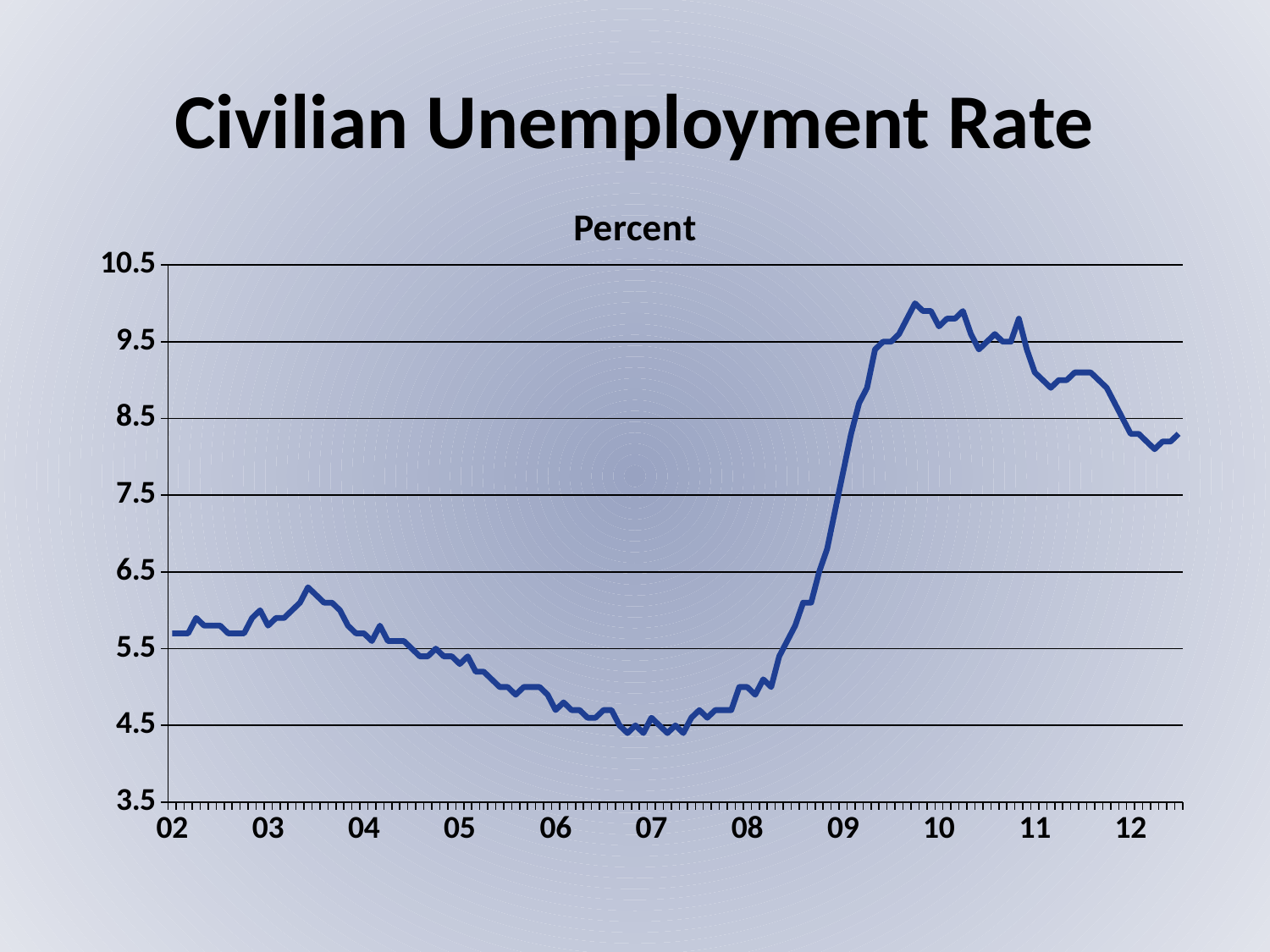
Does the line rise or fall between the 09 tick and the 10 tick? rise How many year labels are shown on the x axis? 11 Which is larger, the value at the 10 tick or the value at the 02 tick? 10 What kind of chart is shown on the slide? line chart What unit label is shown above the plot area? Percent Is the value at the 08 tick greater or less than 5.5? less Is the highest point of the line greater or less than 9.5? greater Does the line rise or fall between the 11 tick and the 12 tick? fall Is the value at the 06 tick greater or less than 5.5? less What is the title of the slide's chart? Percent